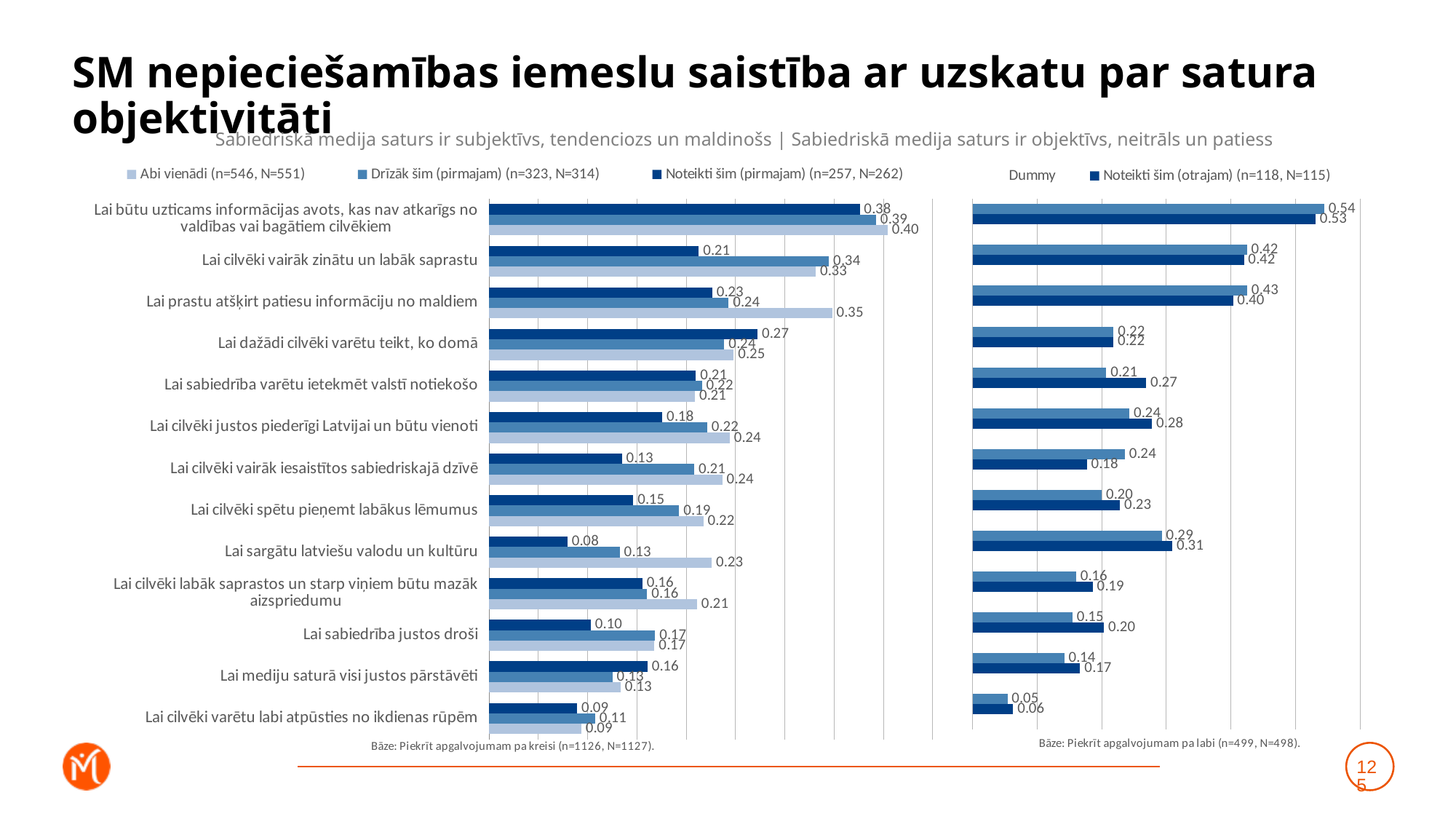
According to the note under the left chart, what is the base (n) for agreeing with the left statement? n=1126, N=1127 In the left chart, what is the value of 'Drīzāk šim (pirmajam)' for 'Lai sabiedrība justos droši'? 0.17 In the left chart, which category has the highest 'Abi vienādi' value? Lai būtu uzticams informācijas avots, kas nav atkarīgs no valdības vai bagātiem cilvēkiem In the left chart, what is the value of 'Noteikti šim (pirmajam)' for 'Lai sargātu latviešu valodu un kultūru'? 0.08 What kind of chart is shown on the slide? bar chart In the right chart, what is the value of 'Noteikti šim (otrajam)' for 'Lai būtu uzticams informācijas avots, kas nav atkarīgs no valdības vai bagātiem cilvēkiem'? 0.53 In the left chart, is the 'Drīzāk šim (pirmajam)' value larger for 'Lai cilvēki vairāk zinātu un labāk saprastu' or for 'Lai prastu atšķirt patiesu informāciju no maldiem'? Lai cilvēki vairāk zinātu un labāk saprastu How many series does the legend list for the left chart? 3 In the left chart, what is the difference between the 'Abi vienādi' and 'Noteikti šim (pirmajam)' values for 'Lai sargātu latviešu valodu un kultūru'? 0.15 How many reason categories are listed on the vertical axis of the chart? 13 In the left chart, what is the value of 'Abi vienādi' for 'Lai prastu atšķirt patiesu informāciju no maldiem'? 0.35 In the left chart, which category has the lowest 'Noteikti šim (pirmajam)' value? Lai sargātu latviešu valodu un kultūru